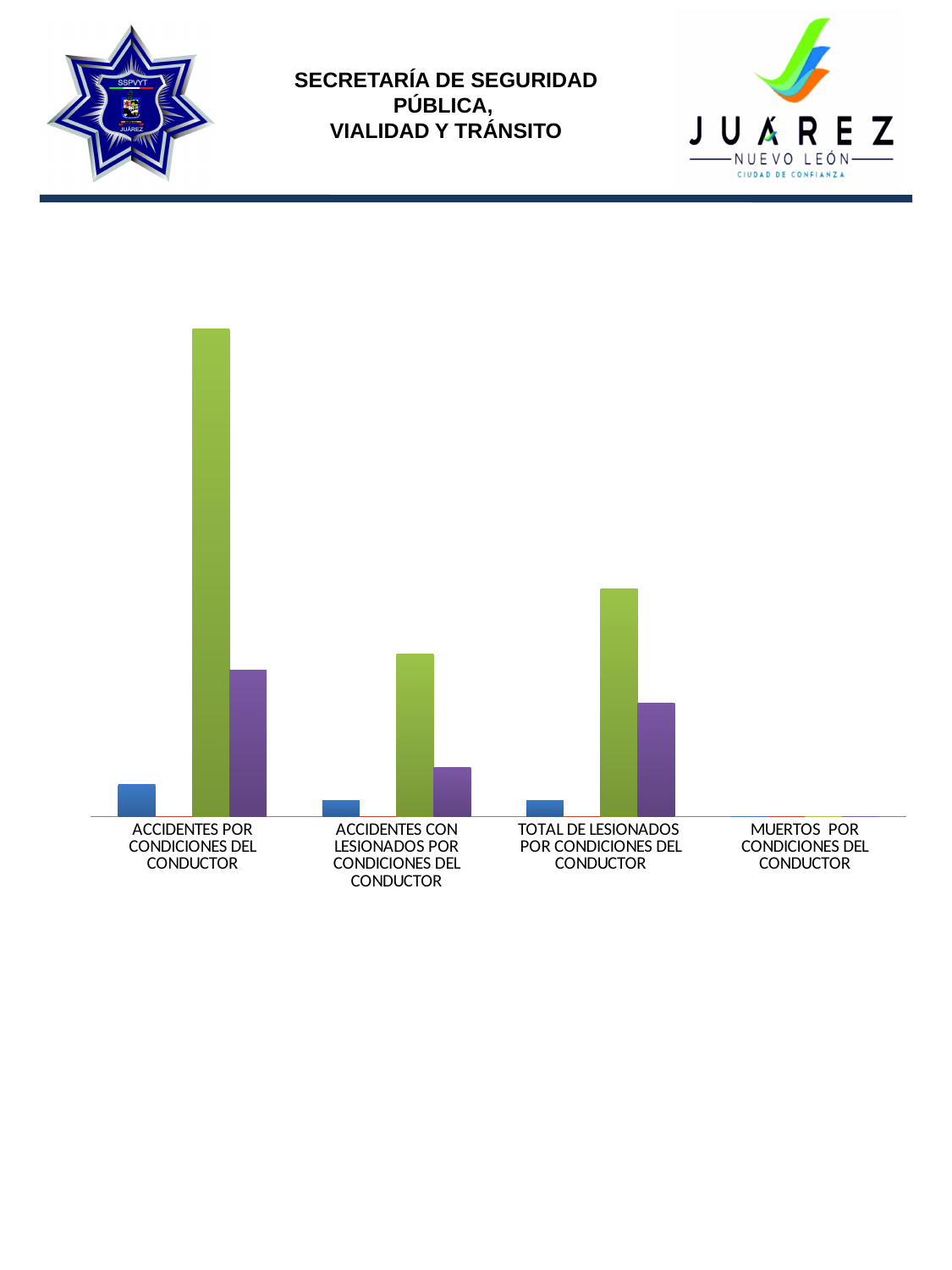
Within the ACCIDENTES POR CONDICIONES DEL CONDUCTOR category, which is taller, the green bar or the purple bar? The green bar Which category contains the tallest bar in the chart? ACCIDENTES POR CONDICIONES DEL CONDUCTOR Is the blue bar taller for ACCIDENTES POR CONDICIONES DEL CONDUCTOR or for ACCIDENTES CON LESIONADOS POR CONDICIONES DEL CONDUCTOR? ACCIDENTES POR CONDICIONES DEL CONDUCTOR What kind of chart is shown on the slide? Bar chart Is the purple bar taller for TOTAL DE LESIONADOS POR CONDICIONES DEL CONDUCTOR or for ACCIDENTES CON LESIONADOS POR CONDICIONES DEL CONDUCTOR? TOTAL DE LESIONADOS POR CONDICIONES DEL CONDUCTOR Does the chart display a legend? No How many categories are shown along the x axis of the chart? 4 Which category has the smallest bars in the chart? MUERTOS POR CONDICIONES DEL CONDUCTOR What colour is the tallest bar in the chart? Green